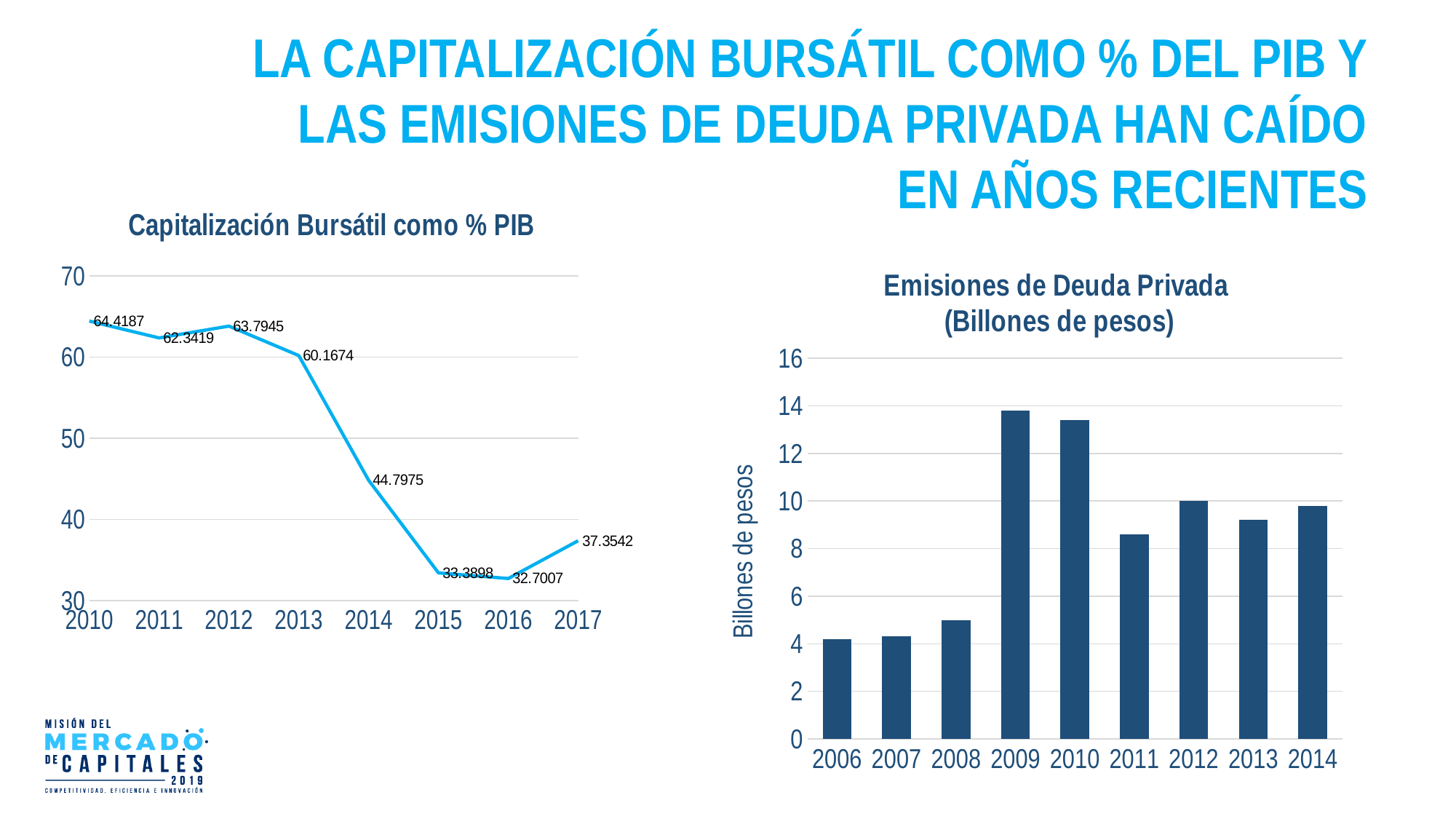
What kind of chart is 'Capitalización Bursátil como % PIB'? Line chart In the 'Emisiones de Deuda Privada' chart, which is larger, the value for 2011 or the value for 2014? 2014 In the 'Capitalización Bursátil como % PIB' chart, what is the value for 2010? 64.4187 In the 'Capitalización Bursátil como % PIB' chart, how many years are plotted? 8 In the 'Capitalización Bursátil como % PIB' chart, what is the difference between the 2013 value and the 2014 value? 15.3699 In the 'Capitalización Bursátil como % PIB' chart, what is the value for 2017? 37.3542 What kind of chart is 'Emisiones de Deuda Privada (Billones de pesos)'? Bar chart In the 'Capitalización Bursátil como % PIB' chart, which year has the highest value? 2010 In the 'Capitalización Bursátil como % PIB' chart, what is the value for 2014? 44.7975 In the 'Capitalización Bursátil como % PIB' chart, which year has the lowest value? 2016 In the 'Emisiones de Deuda Privada' chart, is the value for 2008 greater or less than 6? less In the 'Emisiones de Deuda Privada' chart, is the value for 2009 greater or less than 12? greater